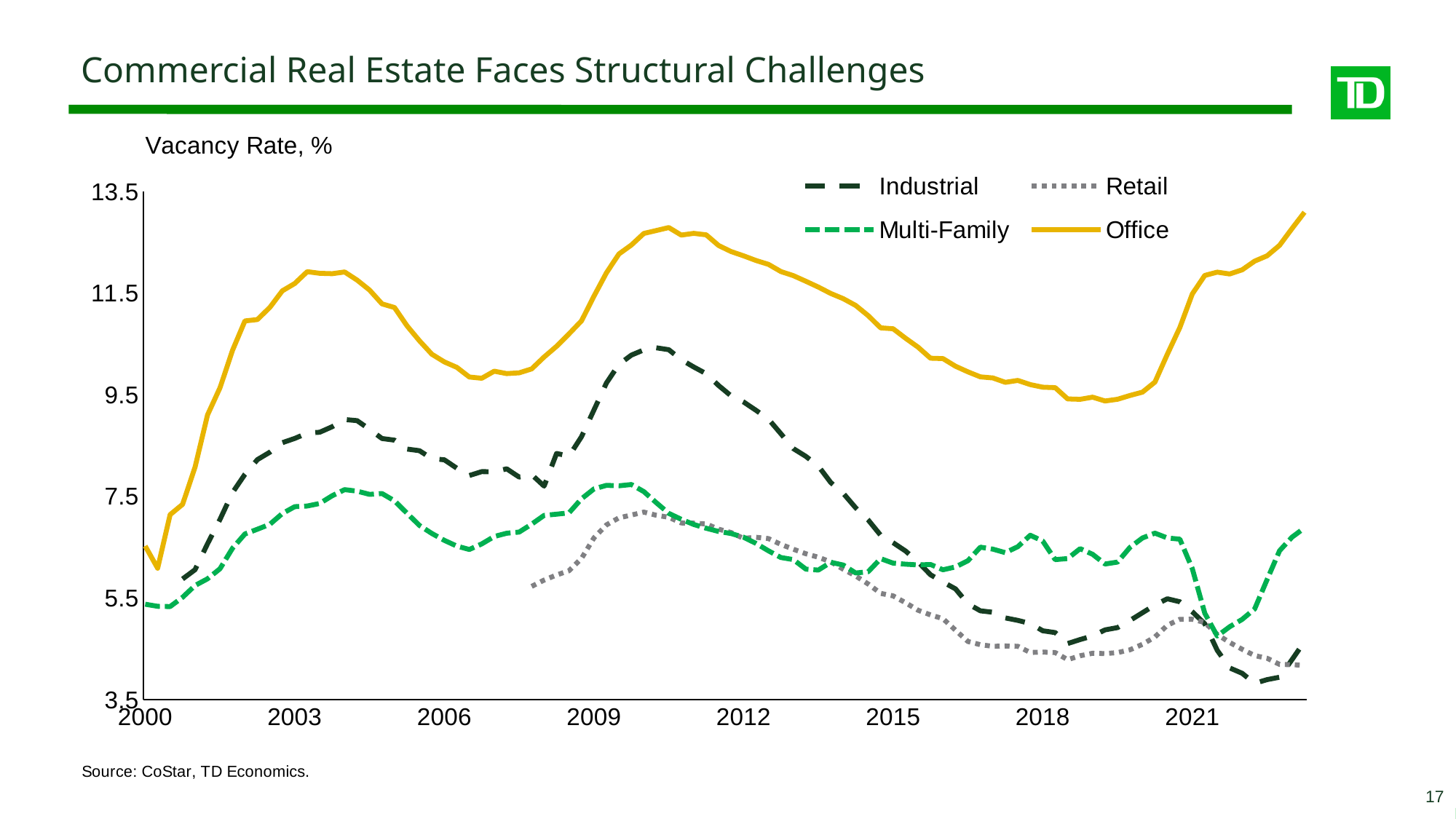
Is the Retail vacancy rate in 2018 greater or less than 5.5? less Which series is drawn as a solid line? Office Which series has the highest vacancy rate at the right end of the chart? Office Which series has the highest vacancy rate in 2012? Office Is the Multi-Family vacancy rate in 2006 greater or less than 7.5? less How many series does the legend list? 4 Is the Industrial vacancy rate in 2009 greater or less than 7.5? greater Does the Industrial vacancy rate rise or fall between 2012 and 2015? fall Which is larger in 2012, the Office vacancy rate or the Industrial vacancy rate? Office Does the Office vacancy rate rise or fall from 2021 to the end of the chart? rise What type of chart is shown on the slide? line chart